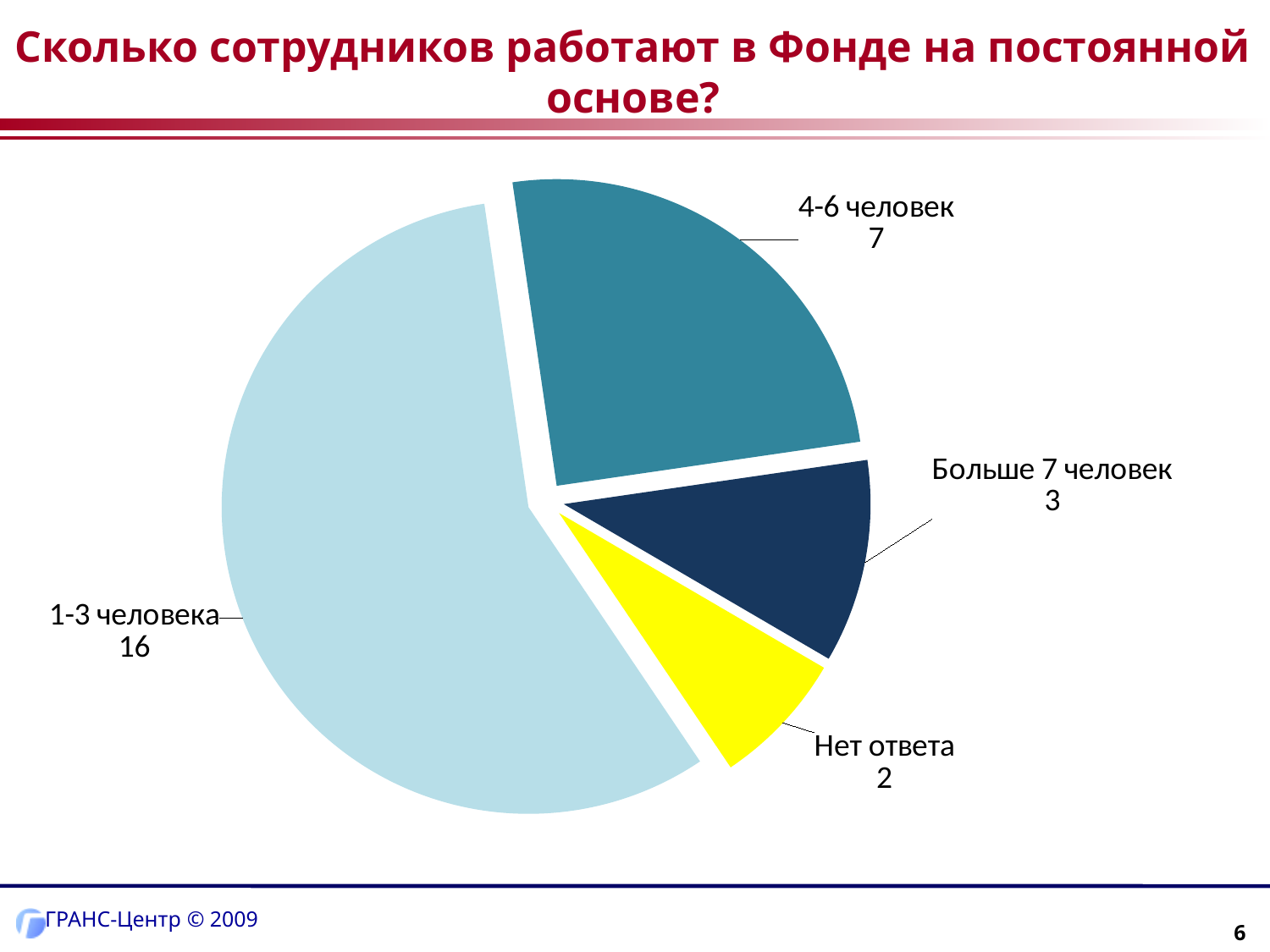
Which category has the largest slice of the pie? 1-3 человека What is the value for the slice labelled "Нет ответа"? 2 What is the value for the slice labelled "1-3 человека"? 16 What share of the pie does the "4-6 человек" slice represent? 25% What is the total of all the slice values in the pie chart? 28 What is the value for the slice labelled "4-6 человек"? 7 What is the value for the slice labelled "Больше 7 человек"? 3 Which category has the smallest slice of the pie? Нет ответа How many slices does the pie chart have? 4 What type of chart is shown on the slide? pie chart Which is larger, the value for "Больше 7 человек" or the value for "Нет ответа"? Больше 7 человек What is the difference between the values for "1-3 человека" and "4-6 человек"? 9